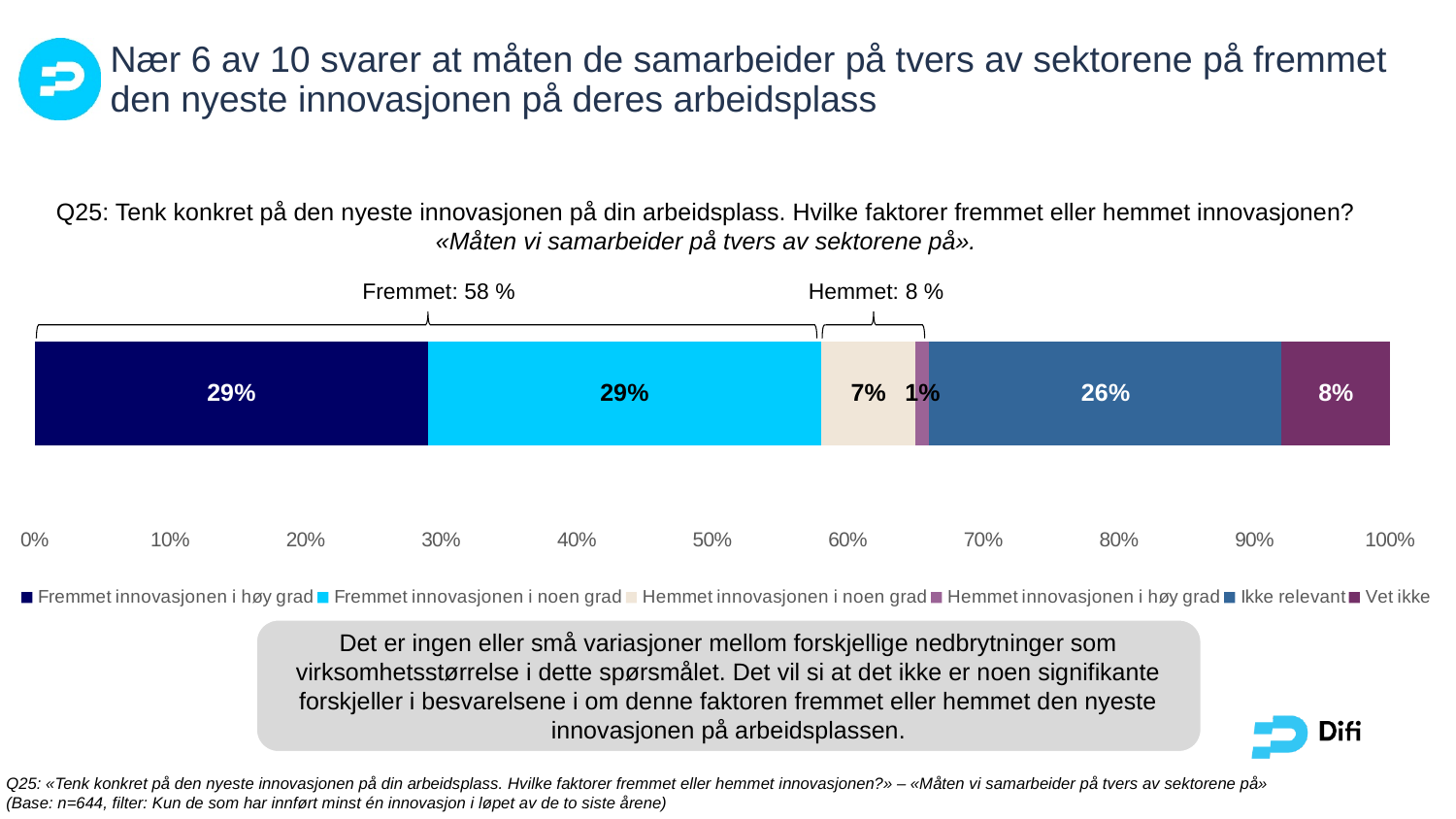
Which response category has the smallest share in the bar? Hemmet innovasjonen i høy grad What percentage of respondents answered "Hemmet innovasjonen i noen grad"? 7% Which is larger: the share for "Hemmet innovasjonen i noen grad" or the share for "Vet ikke"? Vet ikke What kind of chart is shown on the slide? Stacked bar chart What is the highest value shown on the x axis? 100% What is the combined share labelled "Hemmet" above the bar? 8 % What is the difference between the share for "Ikke relevant" and the share for "Vet ikke"? 18% What is the combined share labelled "Fremmet" above the bar? 58 % How many series does the legend list? 6 What percentage of respondents answered "Ikke relevant"? 26% What percentage of respondents answered "Fremmet innovasjonen i høy grad"? 29% What percentage of respondents answered "Vet ikke"? 8%